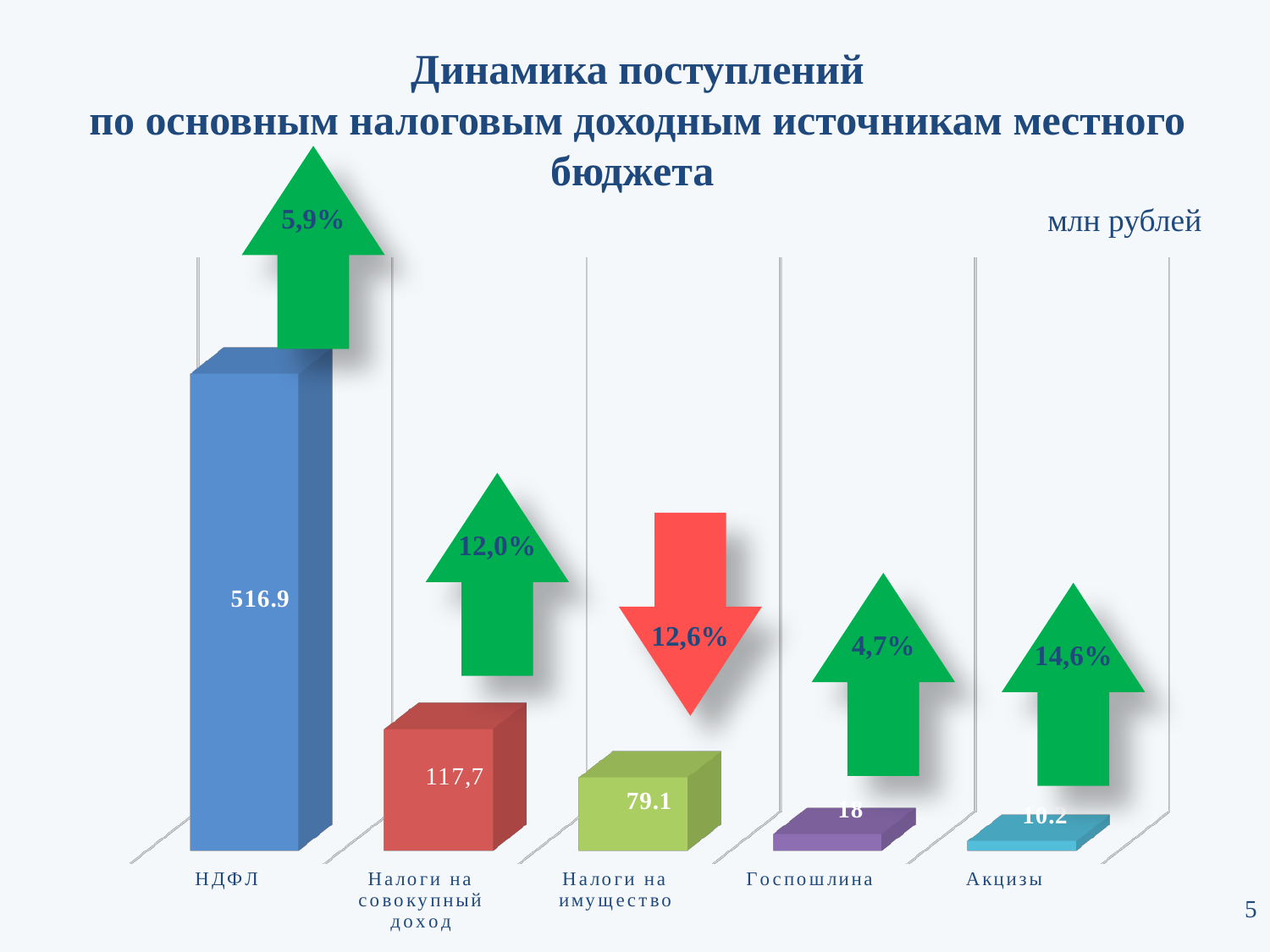
What is the value for Акцизы? 10.2 Which category has the lowest value? Акцизы How many categories are shown in the chart? 5 What kind of chart is shown on the slide? Bar chart What is the value for Налоги на имущество? 79.1 What is the value for Госпошлина? 18 Which category has the highest value? НДФЛ What is the value for Налоги на совокупный доход? 117,7 Which is larger, the value for Налоги на совокупный доход or the value for Налоги на имущество? Налоги на совокупный доход What is the difference between the values for Налоги на имущество and Акцизы? 68.9 What is the difference between the values for Госпошлина and Акцизы? 7.8 What is the value for НДФЛ? 516.9